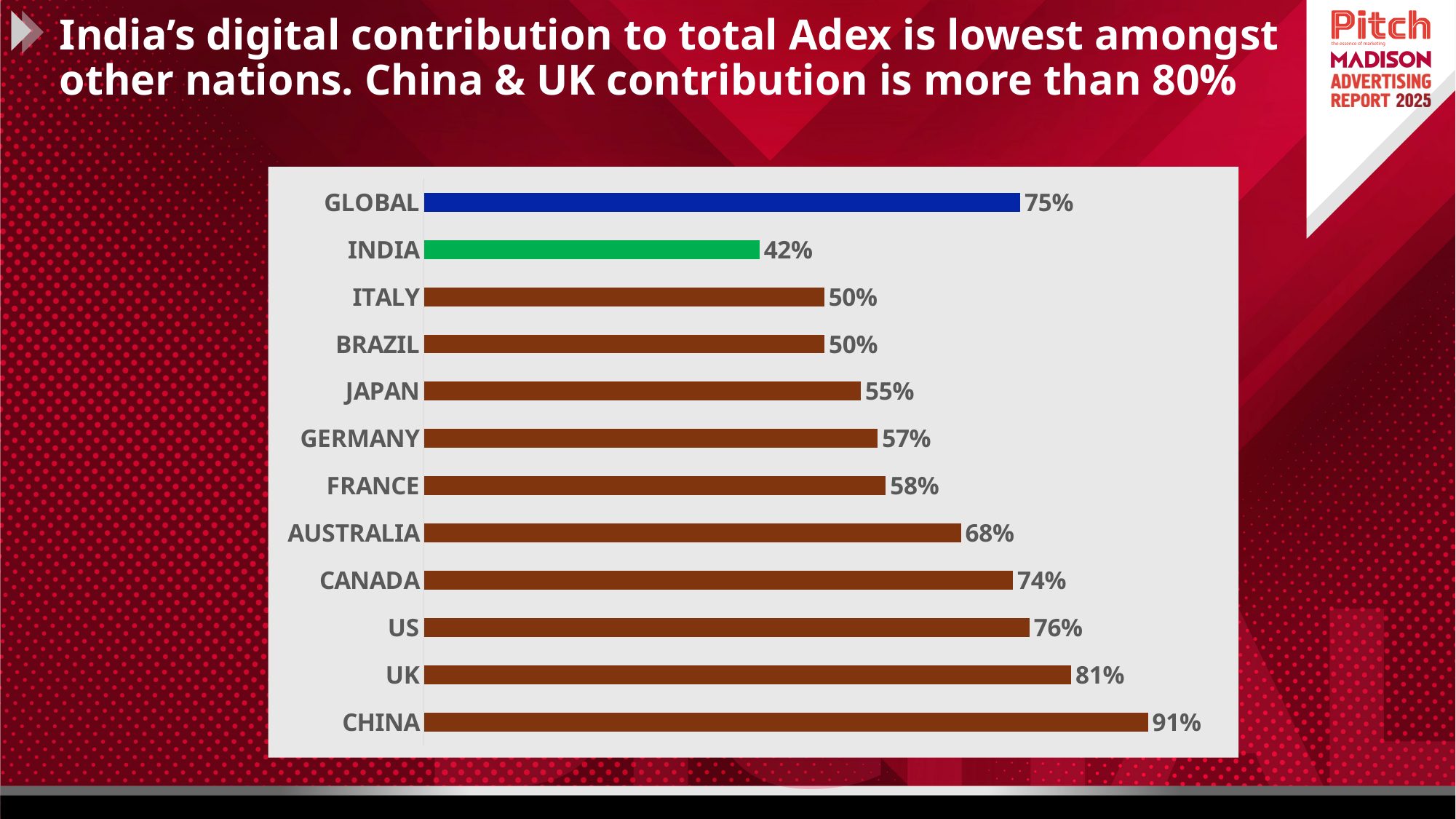
Which has a larger value, Japan or Germany? Germany What is the difference between the values for China and India? 49% What is the difference between the values for UK and US? 5% What is the value shown for Australia? 68% Which has a larger value, Canada or Australia? Canada Which category has the highest value in the chart? China Which category has the lowest value in the chart? India What colour is the bar for India? Green What is the digital contribution value shown for India? 42% What kind of chart is shown on the slide? Bar chart What is the value shown for Global? 75% How many categories (bars) are shown in the chart? 12